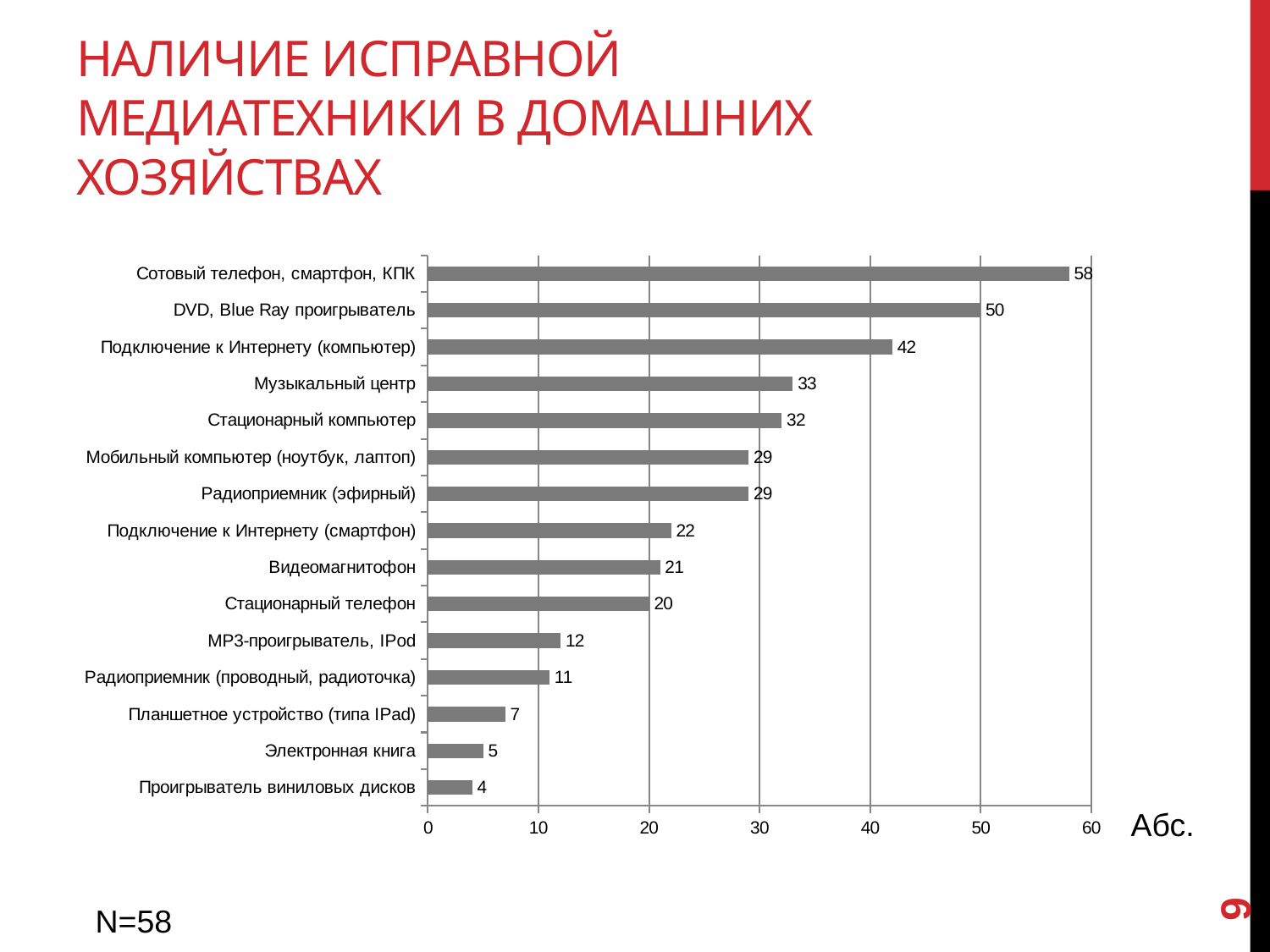
Which is larger: «Музыкальный центр» or «Видеомагнитофон»? Музыкальный центр What is the difference between «Подключение к Интернету (компьютер)» and «Подключение к Интернету (смартфон)»? 20 Which category has the lowest value? Проигрыватель виниловых дисков What is the value for «DVD, Blue Ray проигрыватель»? 50 What kind of chart is shown on the slide? bar chart Which category has the highest value? Сотовый телефон, смартфон, КПК Is the value for «Стационарный компьютер» greater or less than 30? greater How many categories are shown in the chart? 15 What is the label shown at the end of the horizontal axis? Абс. What is the value for «Стационарный телефон»? 20 What is the value for «Планшетное устройство (типа IPad)»? 7 What is the difference between «Сотовый телефон, смартфон, КПК» and «DVD, Blue Ray проигрыватель»? 8